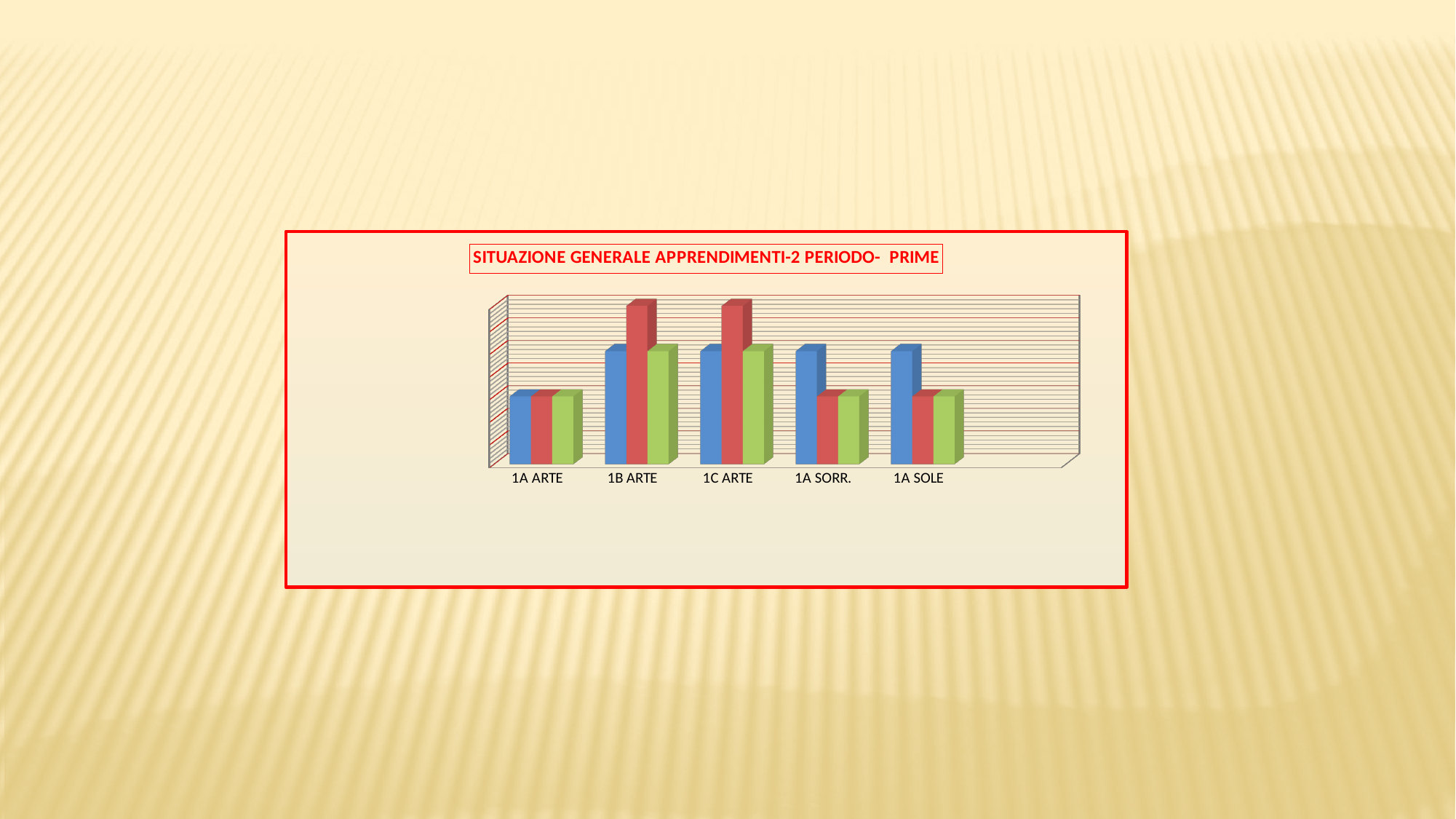
What colours are the three bars in each category of the chart? blue, red and green Which red bar is taller, the one for 1A SOLE or the one for 1C ARTE? 1C ARTE Which category has the lowest blue bar in the chart? 1A ARTE How many bars are plotted for each category in the chart? 3 In the 1B ARTE category, which bar is taller, the red bar or the blue bar? red bar In the 1A SOLE category, which bar is taller, the blue bar or the green bar? blue bar What is the title of the chart? SITUAZIONE GENERALE APPRENDIMENTI-2 PERIODO- PRIME What kind of chart is shown on the slide? bar chart How many categories are shown on the x axis of the chart? 5